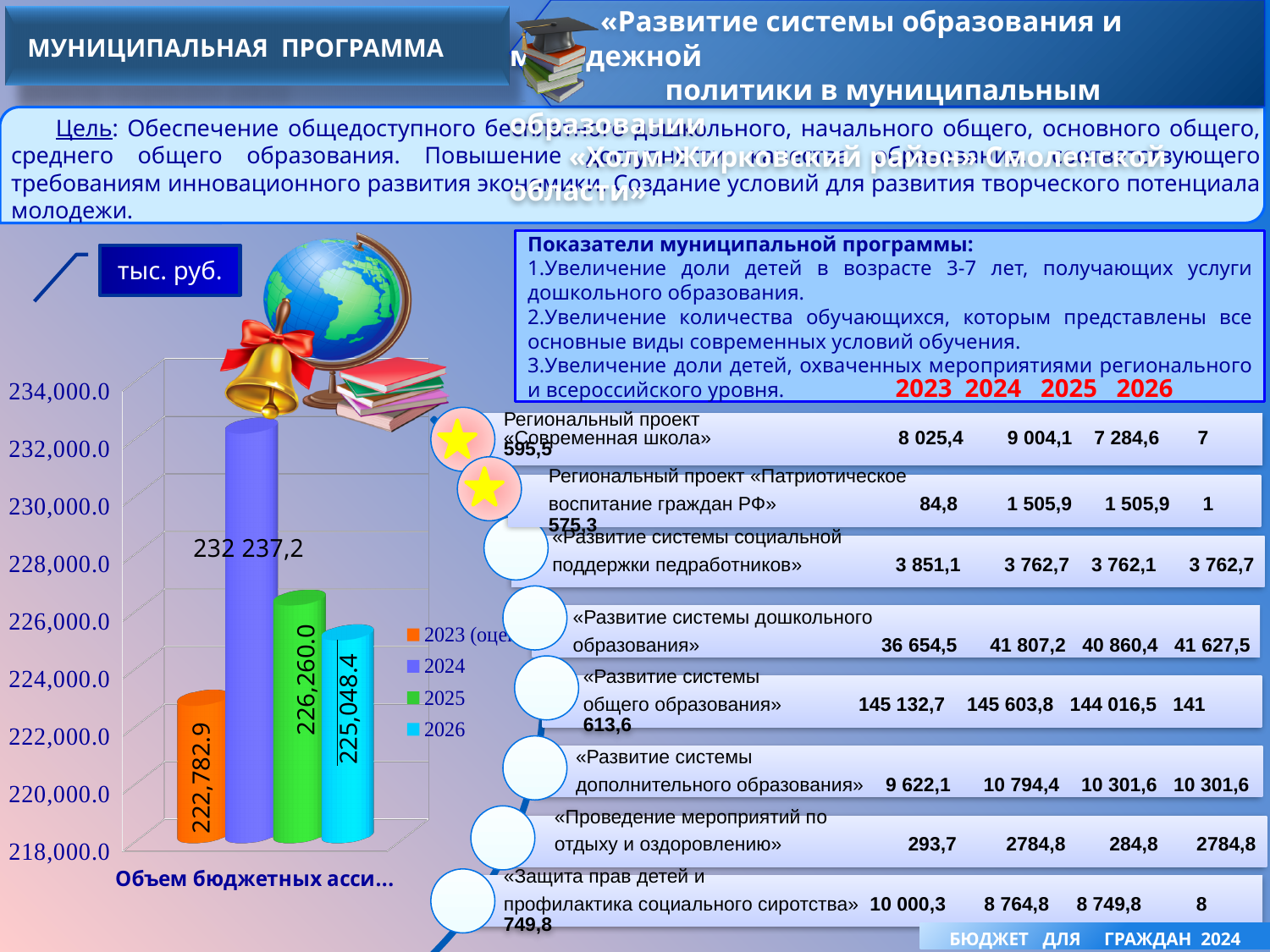
Which year has the lowest bar in the chart? 2023 What unit is indicated for the values in the bar chart? тыс. руб. Which year has the highest bar in the chart? 2024 What is the difference between the 2025 and 2026 values in the chart? 1,211.6 Is the value for 2024 greater or less than 230,000.0? greater What is the value of the 2024 bar in the bar chart? 232 237,2 What is the value of the 2025 bar in the bar chart? 226,260.0 What type of chart is shown on the left of the slide? bar chart What is the value of the 2023 bar in the bar chart? 222,782.9 Which bar is taller, 2025 or 2026? 2025 What is the value of the 2026 bar in the bar chart? 225,048.4 How many bars are plotted in the chart? 4